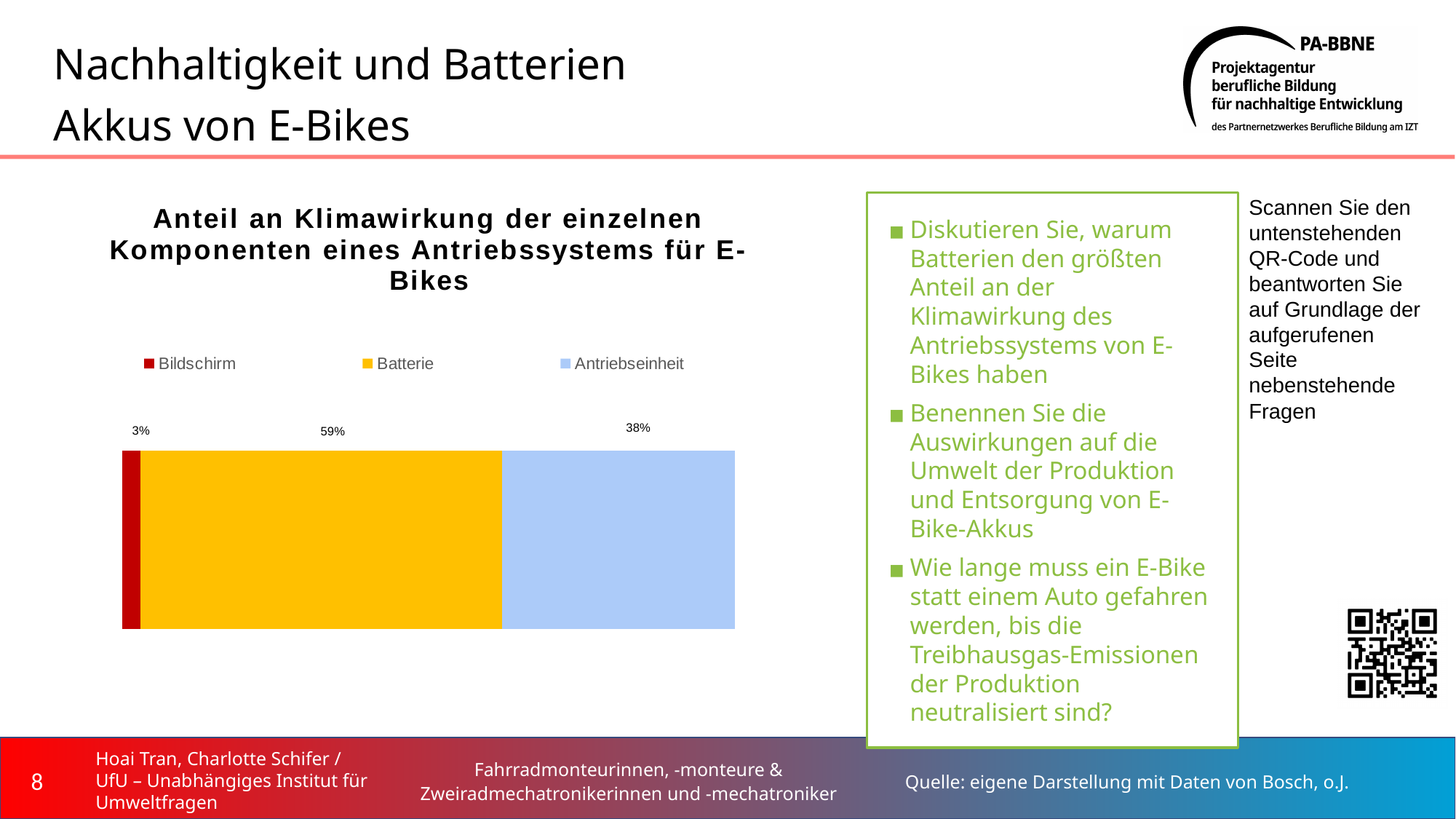
Which component has the smallest share of the climate impact in the chart? Bildschirm What value is shown for Bildschirm in the chart? 3% What is the title of the chart? Anteil an Klimawirkung der einzelnen Komponenten eines Antriebssystems für E-Bikes How many series does the chart legend list? 3 What type of chart is shown on the slide? Stacked bar chart What share of the climate impact does the Batterie segment account for in the chart? 59% Which colour represents Batterie in the chart? Yellow/orange Which component has the largest share of the climate impact in the chart? Batterie What value is shown for Antriebseinheit in the chart? 38% What is the total of the three segments in the stacked bar? 100% What is the difference in percentage points between the Batterie and Antriebseinheit shares? 21 Which is larger, the share for Antriebseinheit or the share for Bildschirm? Antriebseinheit